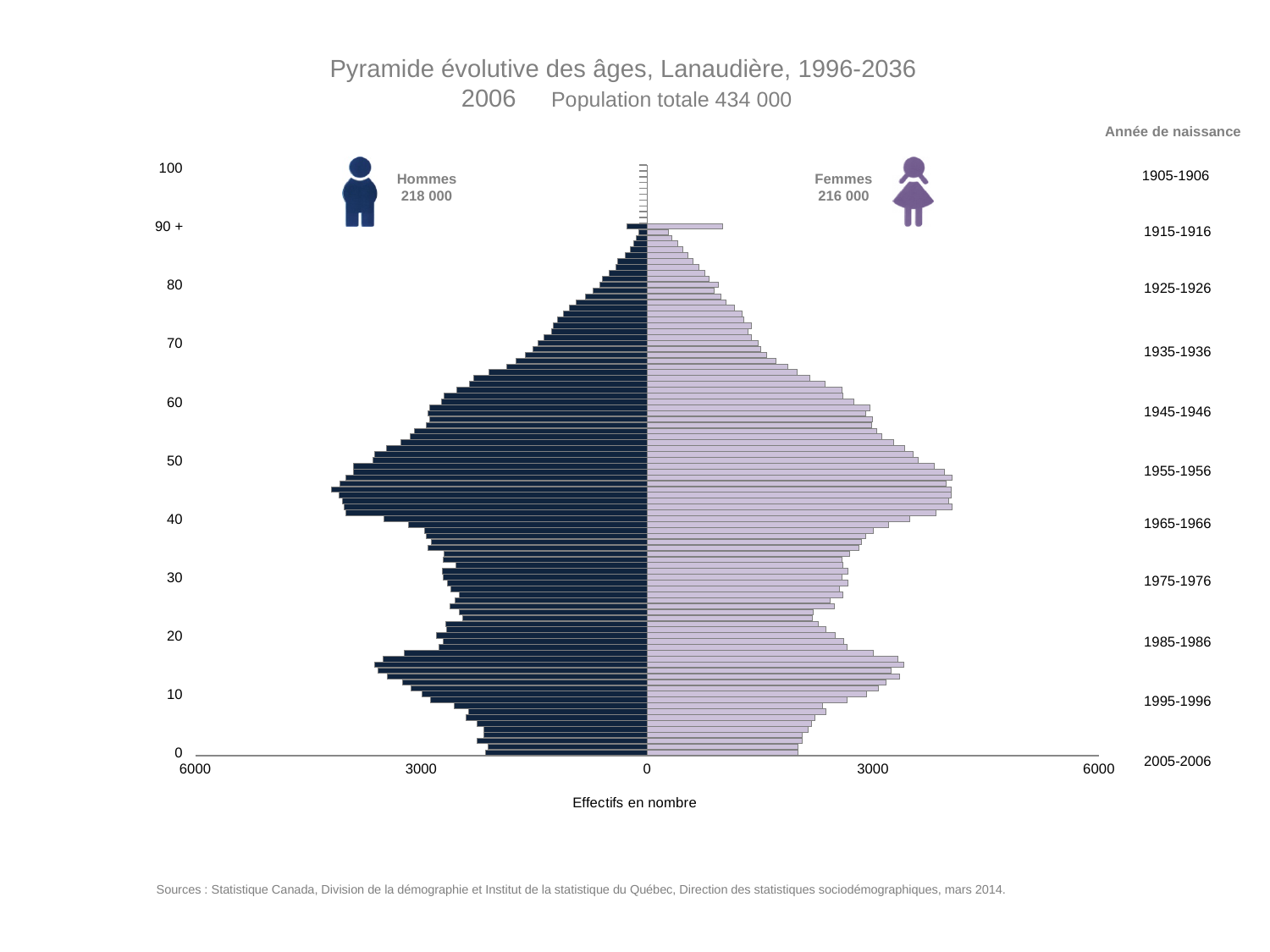
Which group has the larger total, Hommes or Femmes? Hommes What is the label of the horizontal axis? Effectifs en nombre What kind of chart is shown on the slide? Bar chart (population pyramid) What is the total population shown in the chart subtitle? 434 000 Is the value for Femmes at age 90 + greater or less than 3000? less How many series (population groups) does the chart show? 2 Is the value for Hommes at age 0 greater or less than 3000? less What is the total number of Femmes shown on the chart? 216 000 What is the total number of Hommes shown on the chart? 218 000 Which year does this age pyramid represent? 2006 Is the value for Hommes at age 45 greater or less than 3000? greater What is the difference between the Hommes total and the Femmes total? 2 000